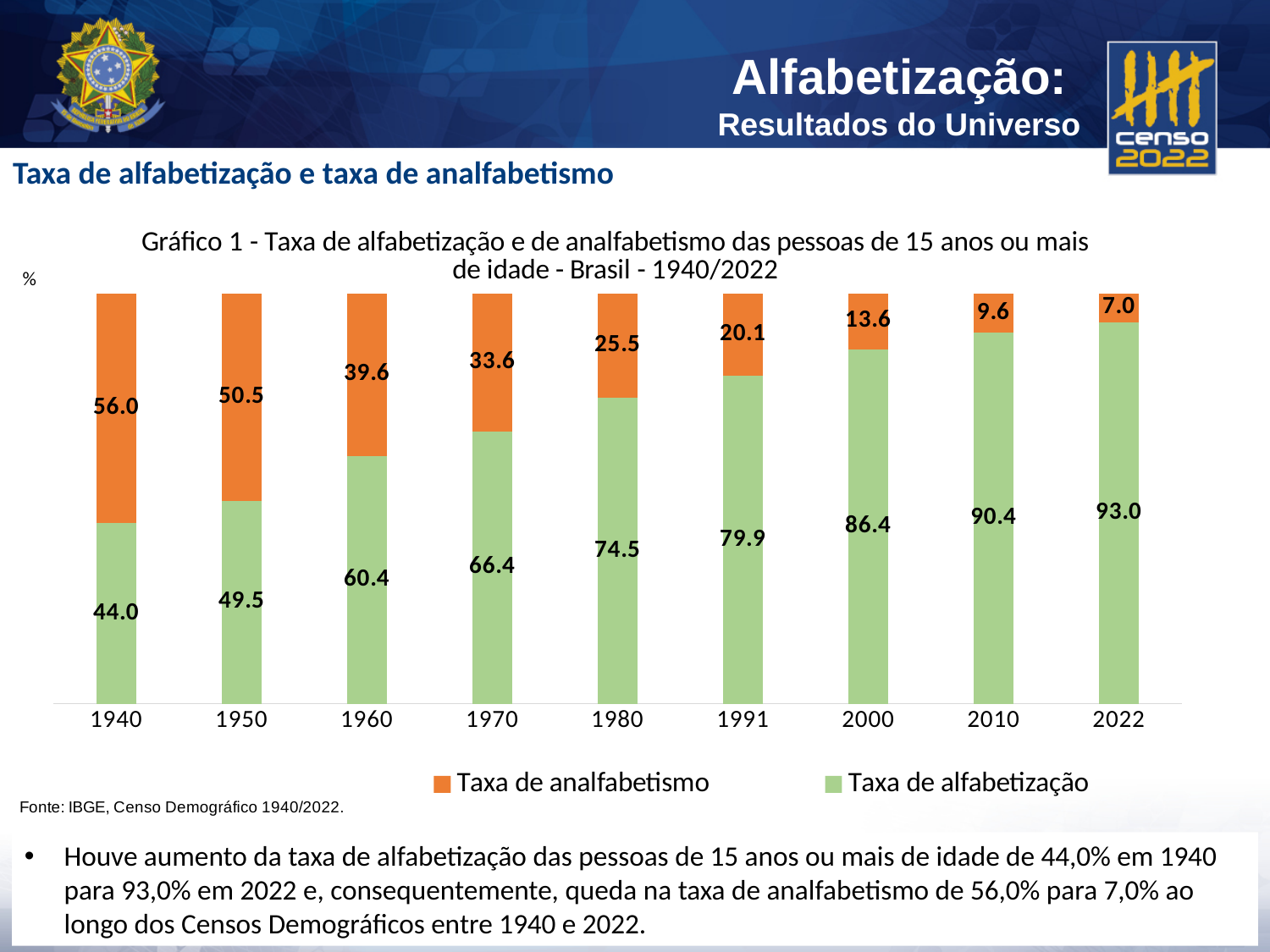
What is the difference between the Taxa de alfabetização in 2022 and in 1940? 49.0 What kind of chart is shown? Stacked bar chart Which year has the lowest Taxa de analfabetismo? 2022 What is the total of the stacked bar for 2000? 100.0 Does the Taxa de alfabetização rise or fall from 1940 to 2022? Rise How many years are shown on the x axis? 9 What is the Taxa de analfabetismo value for 2022? 7.0 How many series does the legend list? 2 Which is larger, the Taxa de analfabetismo in 1960 or in 1991? 1960 Which year has the highest Taxa de alfabetização? 2022 What is the Taxa de alfabetização value for 1980? 74.5 What is the Taxa de alfabetização value for 1940? 44.0